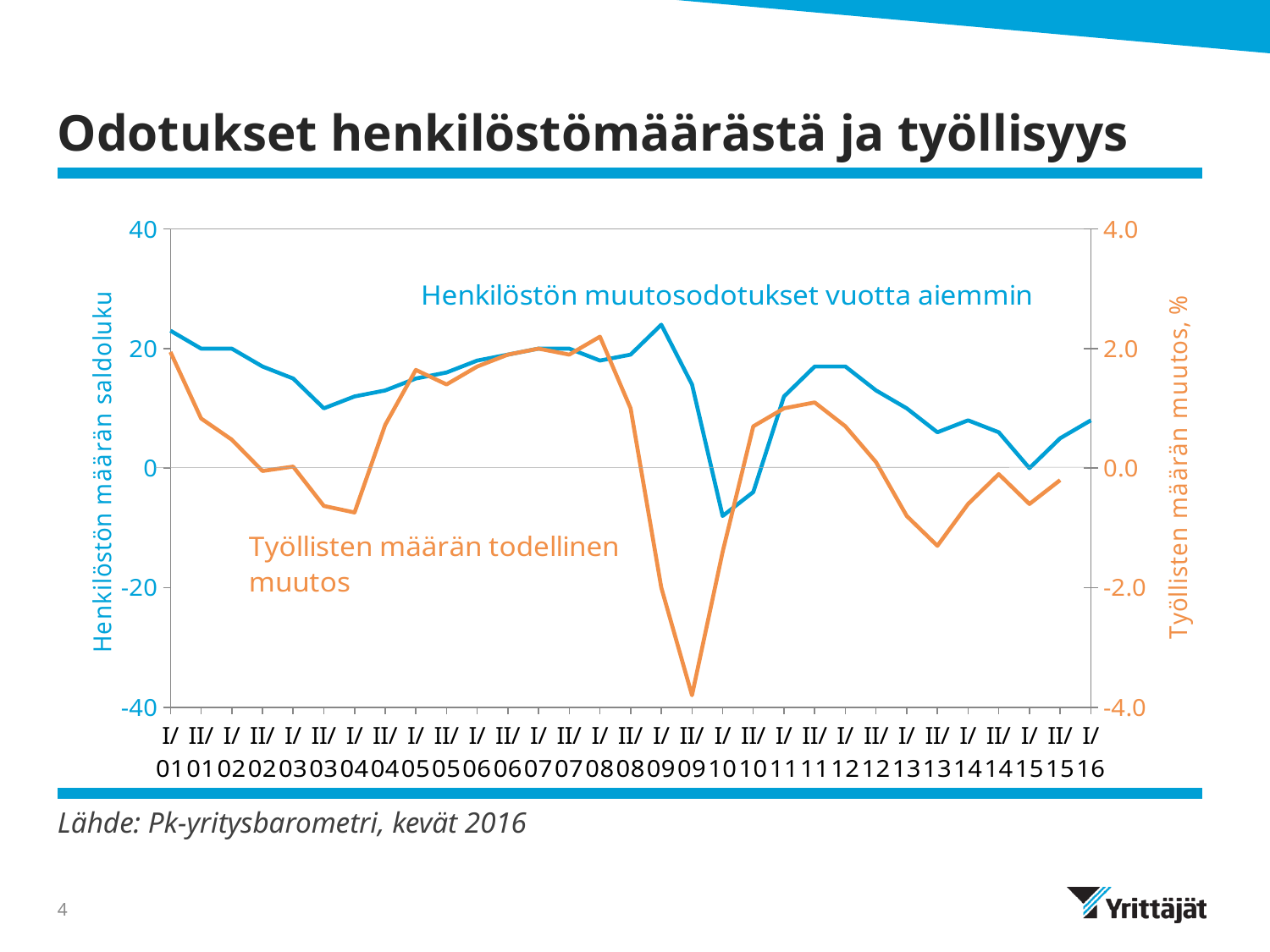
Is the value of 'Henkilöstön muutosodotukset vuotta aiemmin' at I/01 greater or less than 20? greater How many data series are plotted on the chart? 2 Which is larger for 'Henkilöstön muutosodotukset vuotta aiemmin': the value at I/01 or the value at II/03? I/01 At which x-axis point does the series 'Työllisten määrän todellinen muutos' reach its lowest value? II/09 What is the label of the right-hand vertical axis? Työllisten määrän muutos, % Does the series 'Henkilöstön muutosodotukset vuotta aiemmin' rise or fall between I/09 and II/09? fall What is the title of the slide containing the chart? Odotukset henkilöstömäärästä ja työllisyys What kind of chart is shown on the slide? Line chart Is the value of 'Henkilöstön muutosodotukset vuotta aiemmin' at II/03 greater or less than 20? less Does the series 'Työllisten määrän todellinen muutos' rise or fall between II/09 and II/11? rise Is the value of 'Työllisten määrän todellinen muutos' at II/09 greater or less than -2.0? less At which x-axis point does the series 'Henkilöstön muutosodotukset vuotta aiemmin' reach its lowest value? I/10